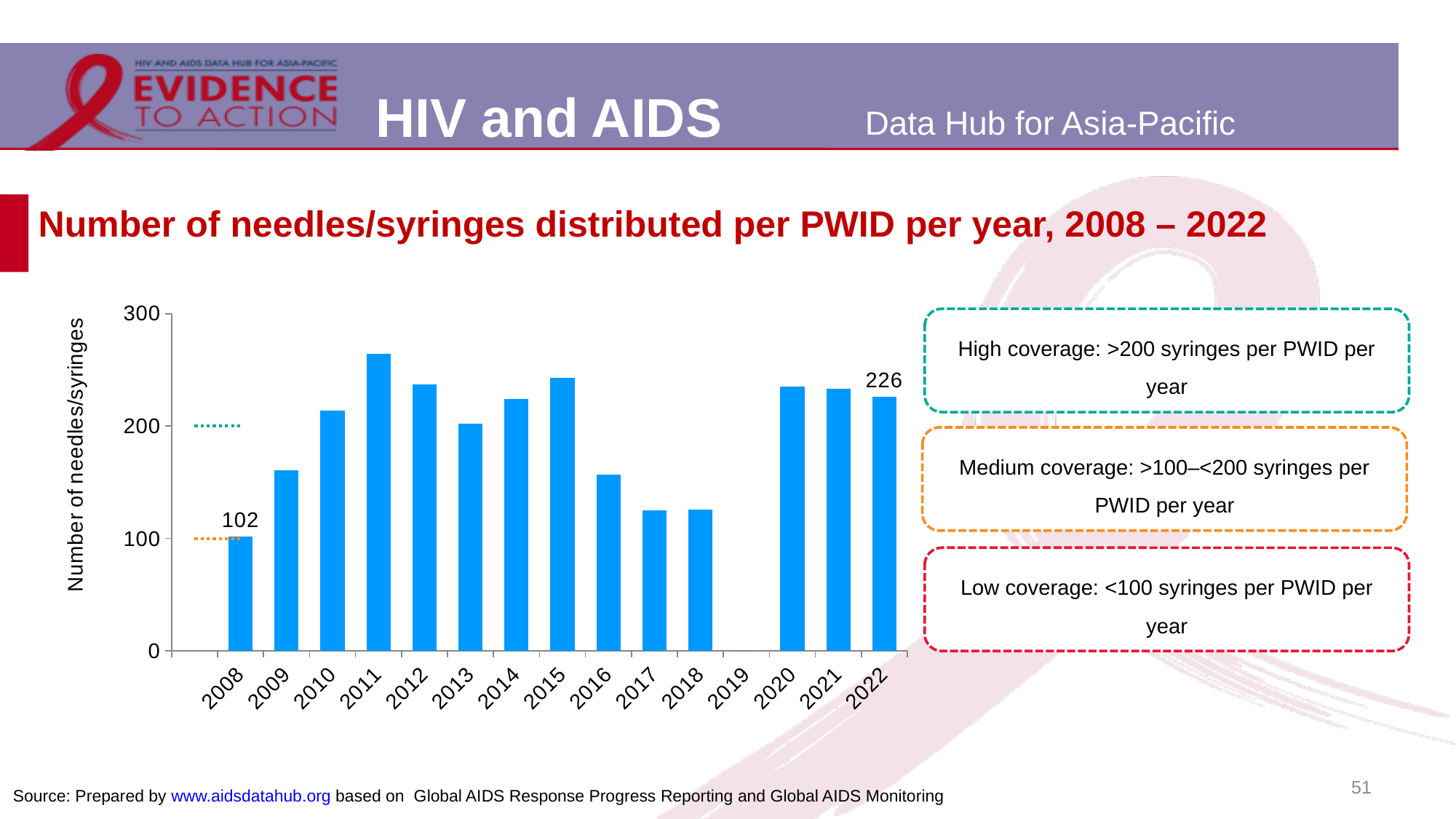
What is the difference between the values for 2022 and 2008? 124 What kind of chart is shown on the slide? Bar chart How many years are labelled on the x axis? 15 Is the value for 2011 greater or less than 200? greater What is the value for 2008? 102 Which year has the highest bar? 2011 Is the value for 2016 greater or less than 200? less What is the value for 2022? 226 Which year has the shortest bar among the years with a bar shown? 2008 Is the value for 2017 greater or less than 100? greater Which is larger, the value for 2011 or the value for 2015? 2011 What is the title of the y axis? Number of needles/syringes